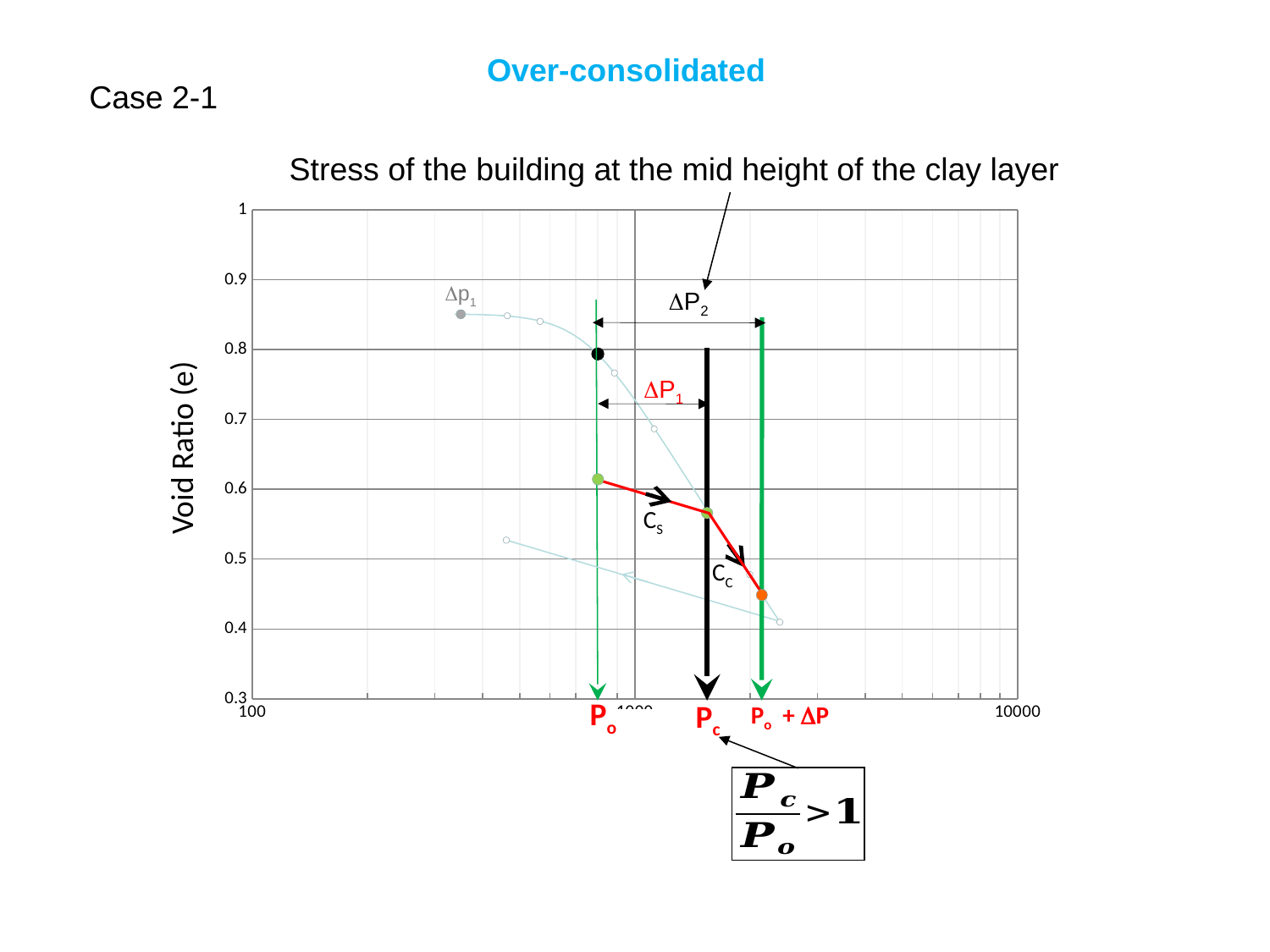
Is the void ratio at the orange point at Po + ΔP greater or less than 0.5? less Is the void ratio where the red line crosses the Pc line greater or less than 0.6? less What is the lowest value shown on the y axis? 0.3 Is the void ratio at the grey Δp1 point greater or less than 0.8? greater What kind of chart is shown on the slide? line chart Which stress increment spans a wider range on the x axis, ΔP1 or ΔP2? ΔP2 Does the red line rise or fall as stress increases from Po to Po + ΔP? fall What is the highest value shown on the x axis? 10000 What is the label of the y axis? Void Ratio (e) Which has the higher void ratio, the green point at Po or the orange point at Po + ΔP? the green point at Po Which of the three marked stresses, Po, Pc or Po + ΔP, lies furthest to the right on the x axis? Po + ΔP